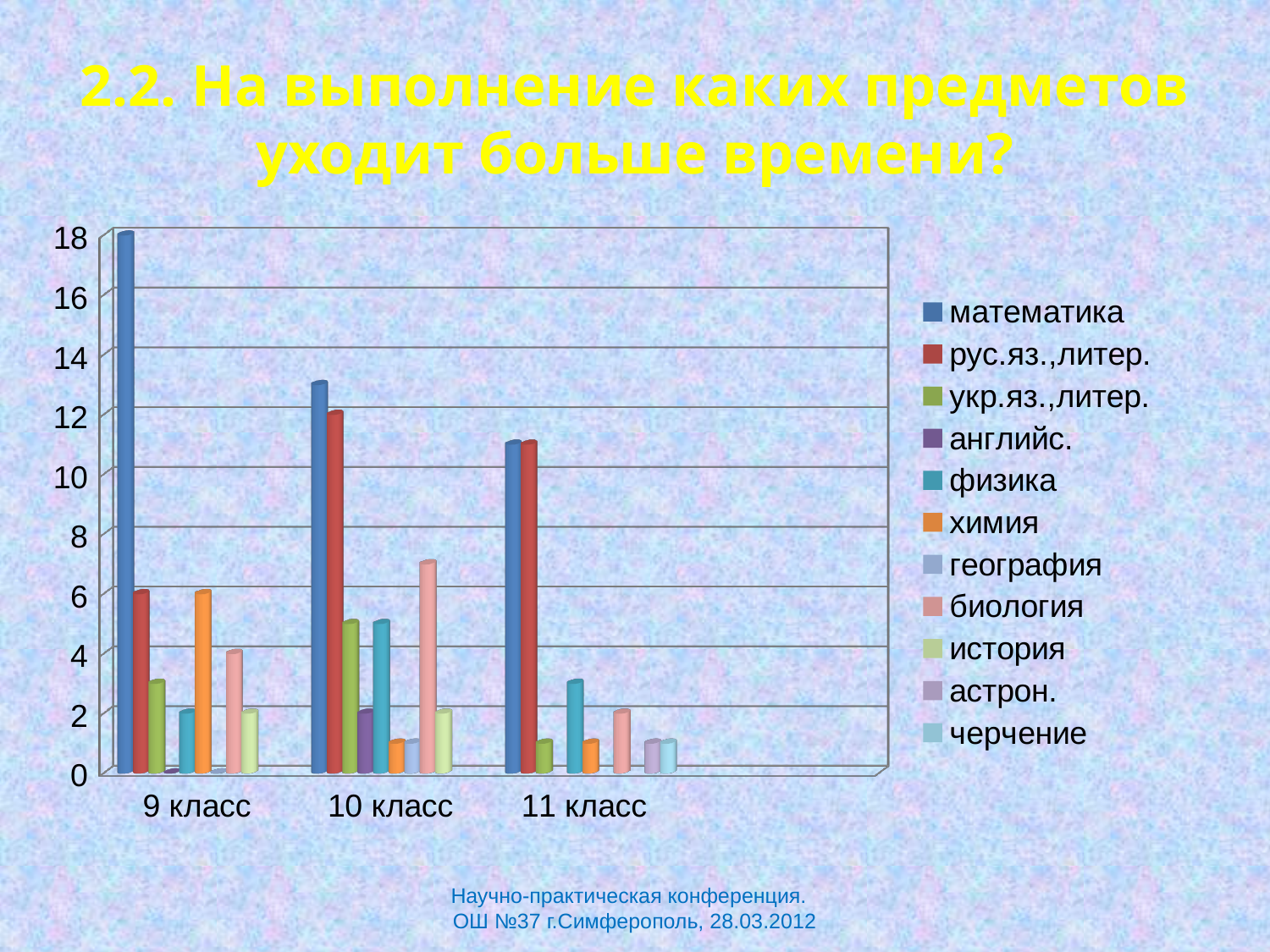
Is the value for физика in 11 класс greater or less than 4? less How many series does the legend list? 11 Which class has the highest bar for математика? 9 класс In 9 класс, which is larger: математика or рус.яз.,литер.? математика What is the value for математика in 9 класс? 18 Which series is listed first in the legend? математика How many class categories are shown on the x axis? 3 Is the value for математика in 10 класс greater or less than 10? greater In 10 класс, which is larger: физика or химия? физика Do the values for математика rise or fall from 9 класс to 11 класс? fall Is the value for биология in 10 класс greater or less than 6? greater What kind of chart is shown on the slide? bar chart